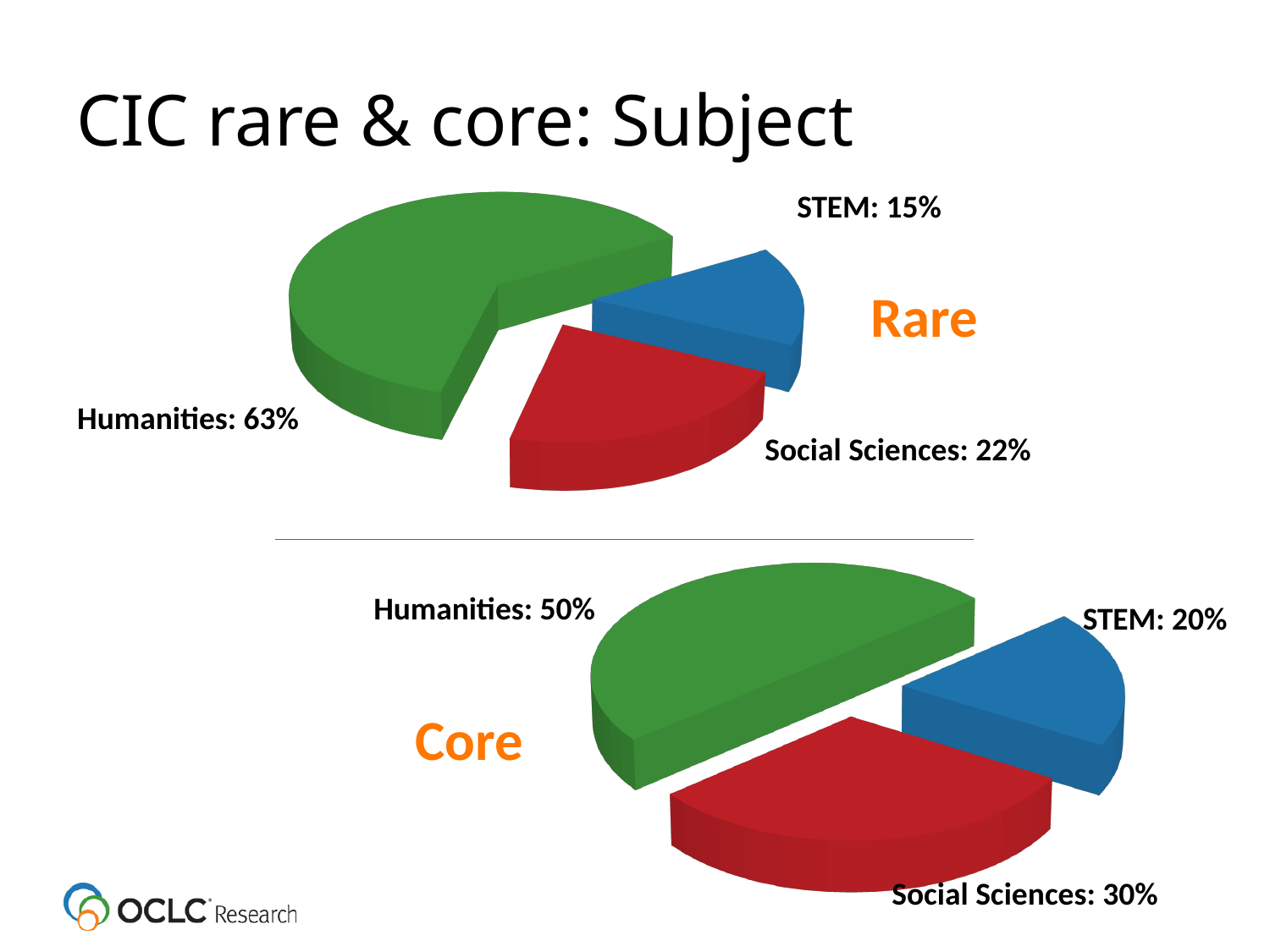
In the Core pie chart, which subject has the smallest share? STEM In the Rare pie chart, what share is STEM? 15% In the Core pie chart, what is the difference between the Social Sciences share and the STEM share? 10 percentage points In the Core pie chart, what share is Humanities? 50% In the Rare pie chart, which subject has the largest share? Humanities In the Rare pie chart, what colour is the Social Sciences slice? Red In the Rare pie chart, what share is Humanities? 63% In the Core pie chart, what share is Social Sciences? 30% Which chart shows a larger share for STEM, the Rare chart or the Core chart? Core In the Rare pie chart, what is the difference between the Humanities share and the Social Sciences share? 41 percentage points How many slices does the Core pie chart have? 3 What kind of chart is the Rare chart? Pie chart